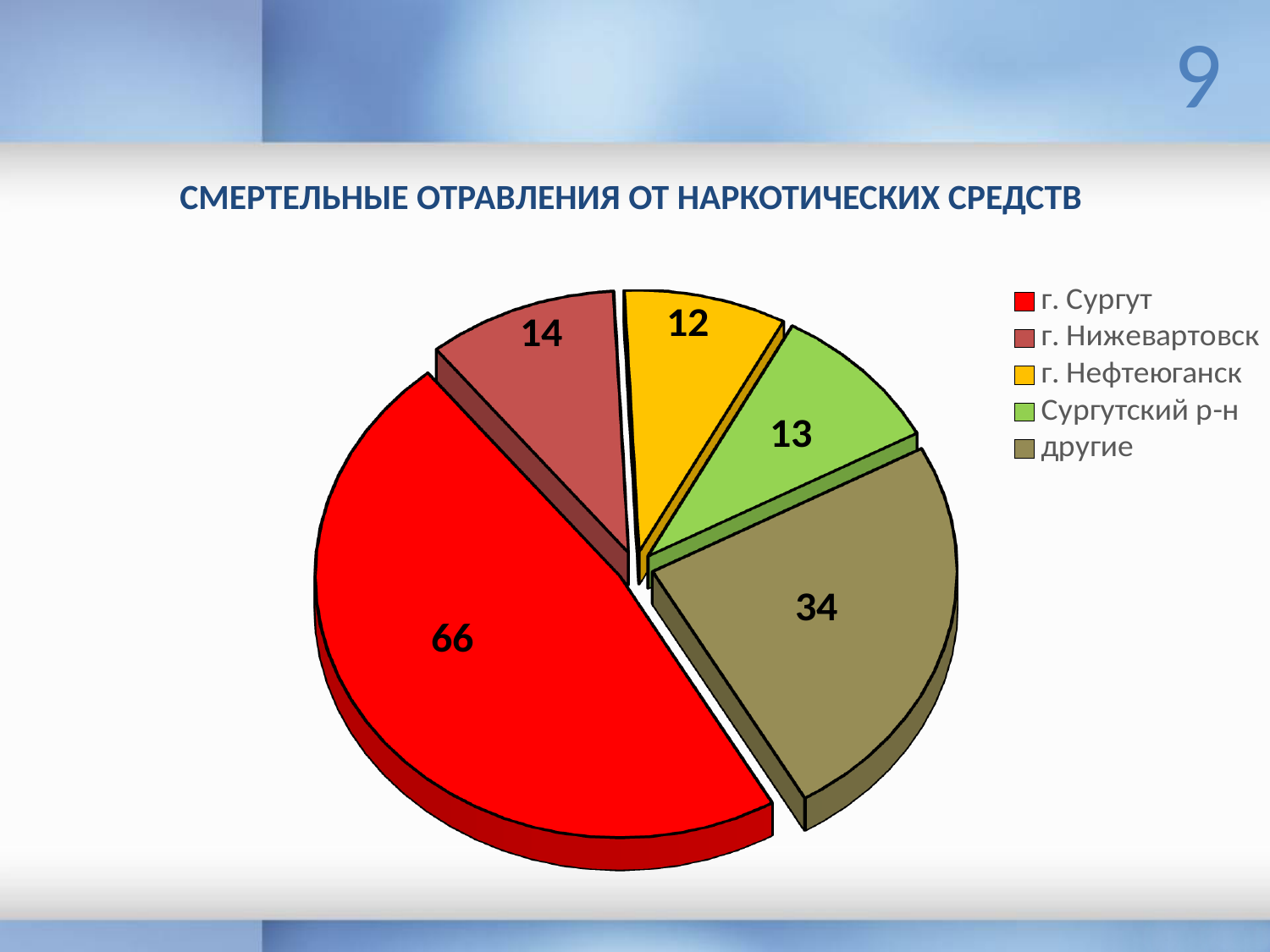
What is the value for г. Нижевартовск? 14 What is the value for Сургутский р-н? 13 Which category has the smallest slice? г. Нефтеюганск What is the difference between the values for г. Сургут and другие? 32 Which is larger, the value for г. Нижевартовск or the value for Сургутский р-н? г. Нижевартовск Which category has the largest slice? г. Сургут What is the value for the slice labelled другие? 34 How many categories does the legend list? 5 What is the value for г. Нефтеюганск? 12 What is the title of the chart? СМЕРТЕЛЬНЫЕ ОТРАВЛЕНИЯ ОТ НАРКОТИЧЕСКИХ СРЕДСТВ What is the value for г. Сургут? 66 What type of chart is shown on the slide? Pie chart